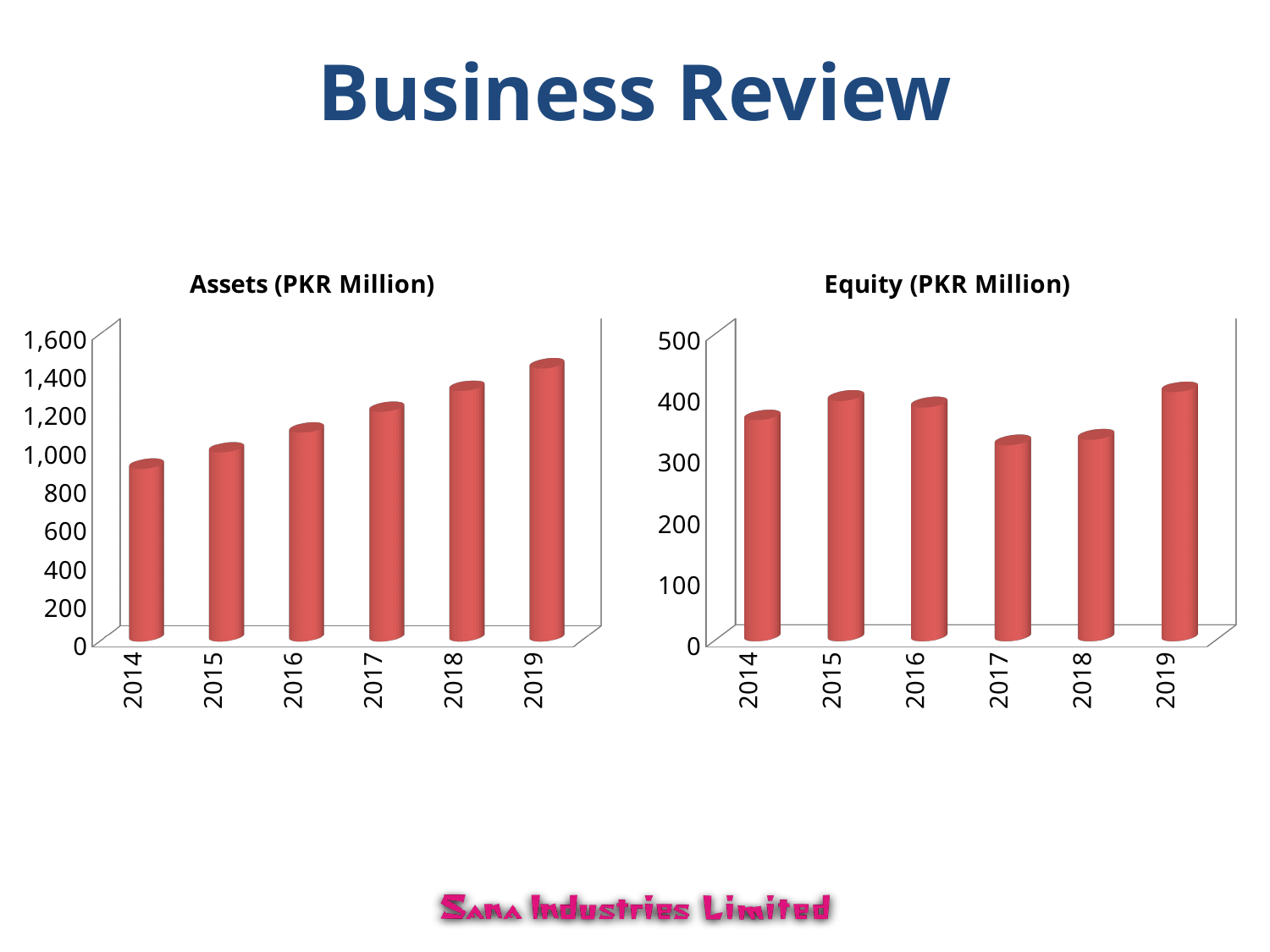
In the Assets (PKR Million) chart, which year has the lowest value? 2014 In the Assets (PKR Million) chart, is the value for 2019 greater or less than 1,200? greater In the Equity (PKR Million) chart, which is larger, the value for 2015 or the value for 2017? 2015 In the Equity (PKR Million) chart, which year has the highest value? 2019 In the Assets (PKR Million) chart, do the values rise or fall from 2014 to 2019? rise In the Equity (PKR Million) chart, is the value for 2015 greater or less than 300? greater In the Assets (PKR Million) chart, which year has the highest value? 2019 What kind of chart is the Assets (PKR Million) chart? bar chart In the Assets (PKR Million) chart, is the value for 2014 greater or less than 1,000? less How many years are shown on the Assets (PKR Million) chart? 6 What is the title of the chart on the right side of the slide? Equity (PKR Million)